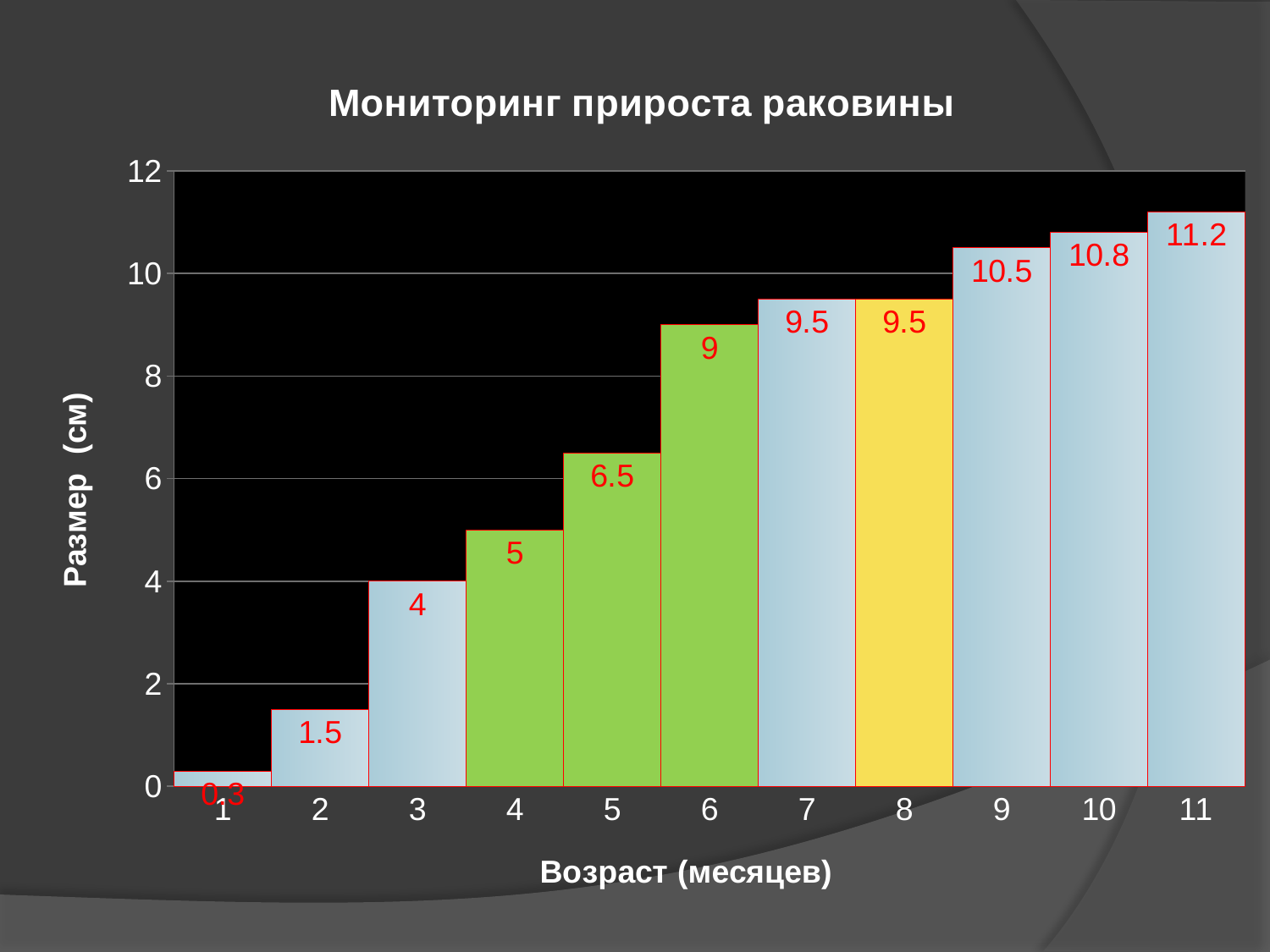
At which age (in months) is the shell size the largest? 11 Which is larger, the shell size at age 3 months or at age 6 months? 6 months What is the shell size at age 2 months? 1.5 Do the shell size values rise or fall as age increases along the x axis? Rise At which age (in months) is the shell size the smallest? 1 What is the difference in shell size between age 5 months and age 4 months? 1.5 What is the difference in shell size between age 10 months and age 9 months? 0.3 What is the shell size at age 6 months? 9 What is the title of the chart? Мониторинг прироста раковины How many age categories are shown on the x axis? 11 What is the shell size at age 11 months? 11.2 What kind of chart is shown on the slide? Bar chart